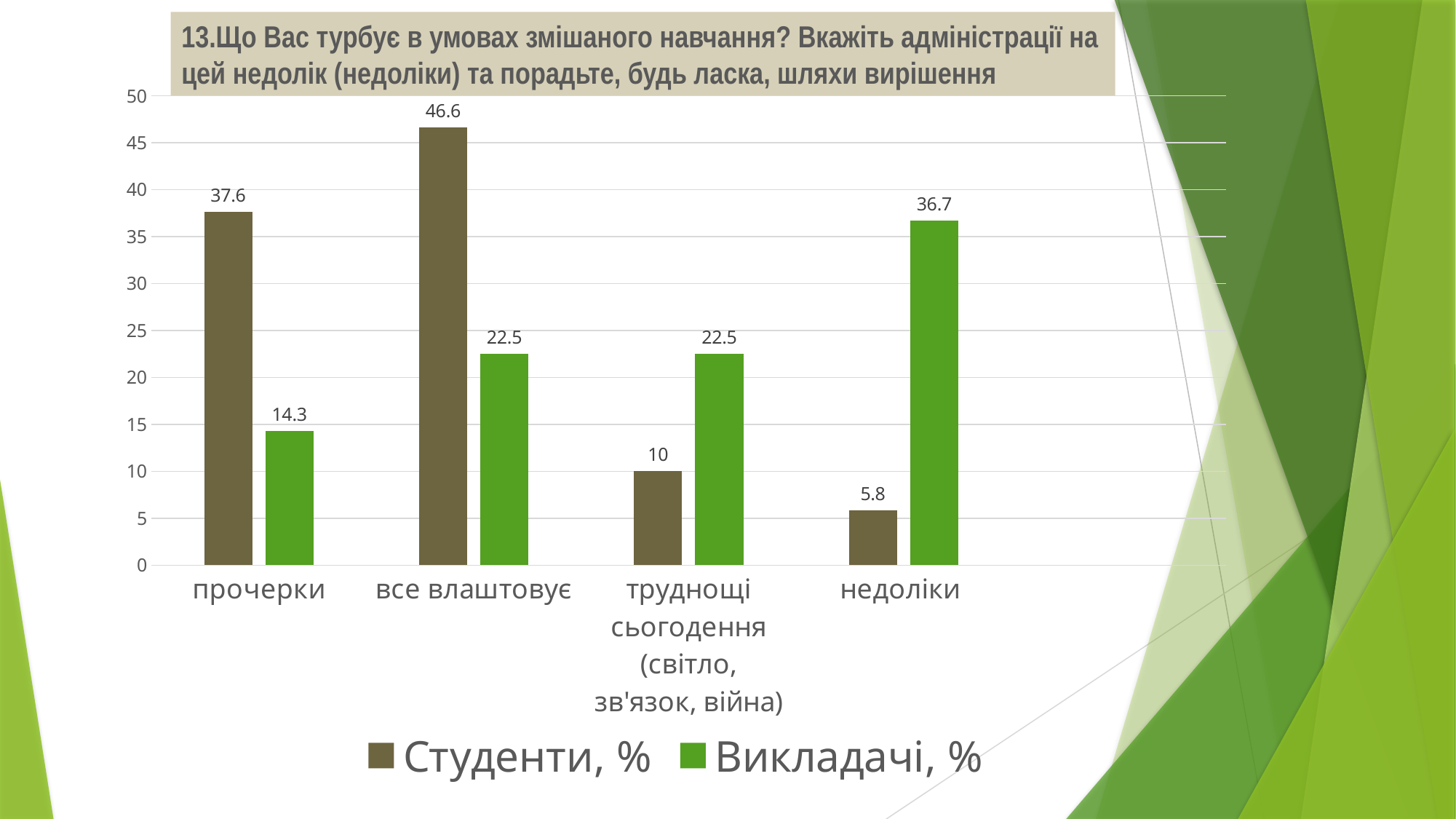
What is the value for Викладачі, % in the недоліки category? 36.7 What is the value for Студенти, % in the все влаштовує category? 46.6 In the недоліки category, which series has the larger value: Студенти, % or Викладачі, %? Викладачі, % Which category has the highest value for Студенти, %? все влаштовує What colour are the bars for the Викладачі, % series? green Which category has the lowest value for Студенти, %? недоліки How many series does the legend list? 2 What kind of chart is shown on the slide? bar chart What is the value for Студенти, % in the прочерки category? 37.6 What is the difference between the Студенти, % and Викладачі, % values in the все влаштовує category? 24.1 Which category has the lowest value for Викладачі, %? прочерки How many categories are shown on the x axis? 4